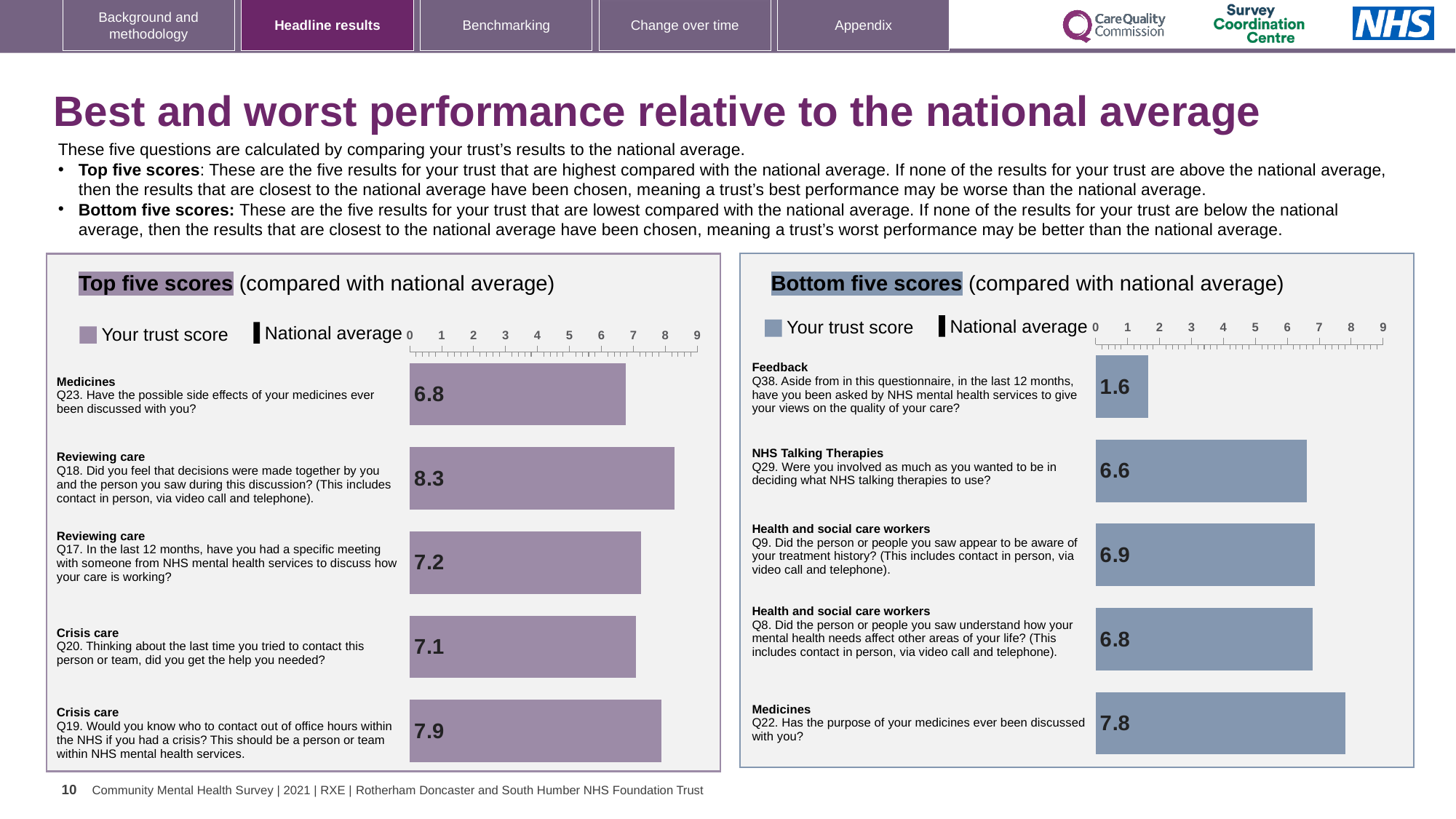
In the Bottom five scores chart, which question has the lowest trust score? Q38 In the Top five scores chart, which question has the lowest trust score? Q23 In the Bottom five scores chart, which has the larger trust score, Q9 or Q29? Q9 What kind of chart is the Bottom five scores chart? Bar chart How many bars are shown in the Top five scores chart? 5 In the Top five scores chart, which question has the highest trust score? Q18 In the Bottom five scores chart, what is the difference between the trust scores for Q22 and Q38? 6.2 In the Top five scores chart, what is the difference between the trust scores for Q18 and Q20? 1.2 In the Bottom five scores chart, which question has the highest trust score? Q22 In the Bottom five scores chart, what is the trust score for Q38 (Feedback)? 1.6 In the Top five scores chart, what is the trust score for Q23 (Medicines)? 6.8 How many entries does the legend of the Top five scores chart list? 2